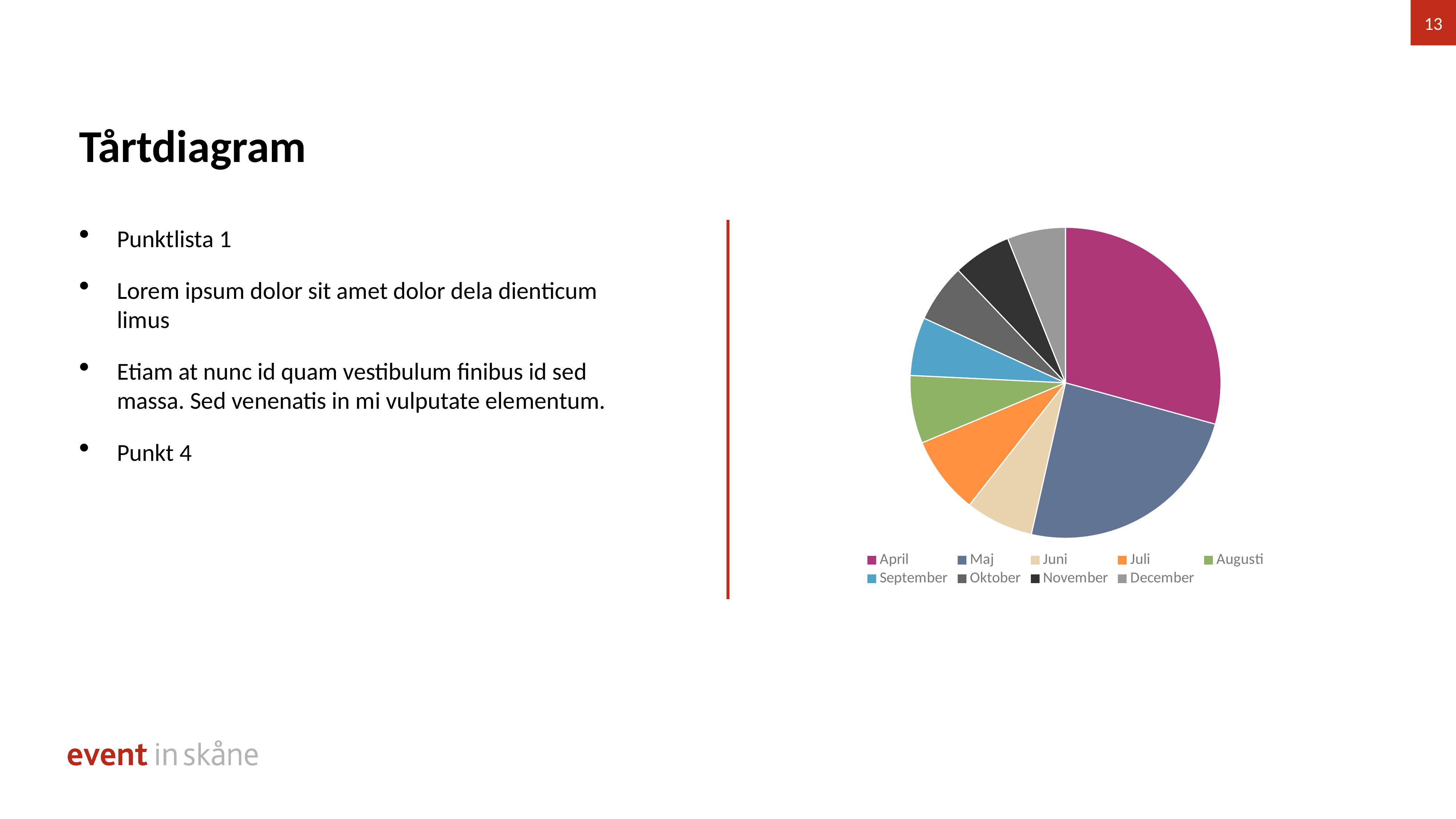
What kind of chart is shown on the slide? pie chart Which slice is larger, April or September? April What colour is the April slice in the pie chart? magenta Which slice is larger, April or Maj? April How many categories (slices) does the pie chart have? 9 Which category has the largest slice in the pie chart? April What is the title of the slide containing the pie chart? Tårtdiagram Which category is listed first in the pie chart's legend? April Which slice is larger, Juli or December? Juli